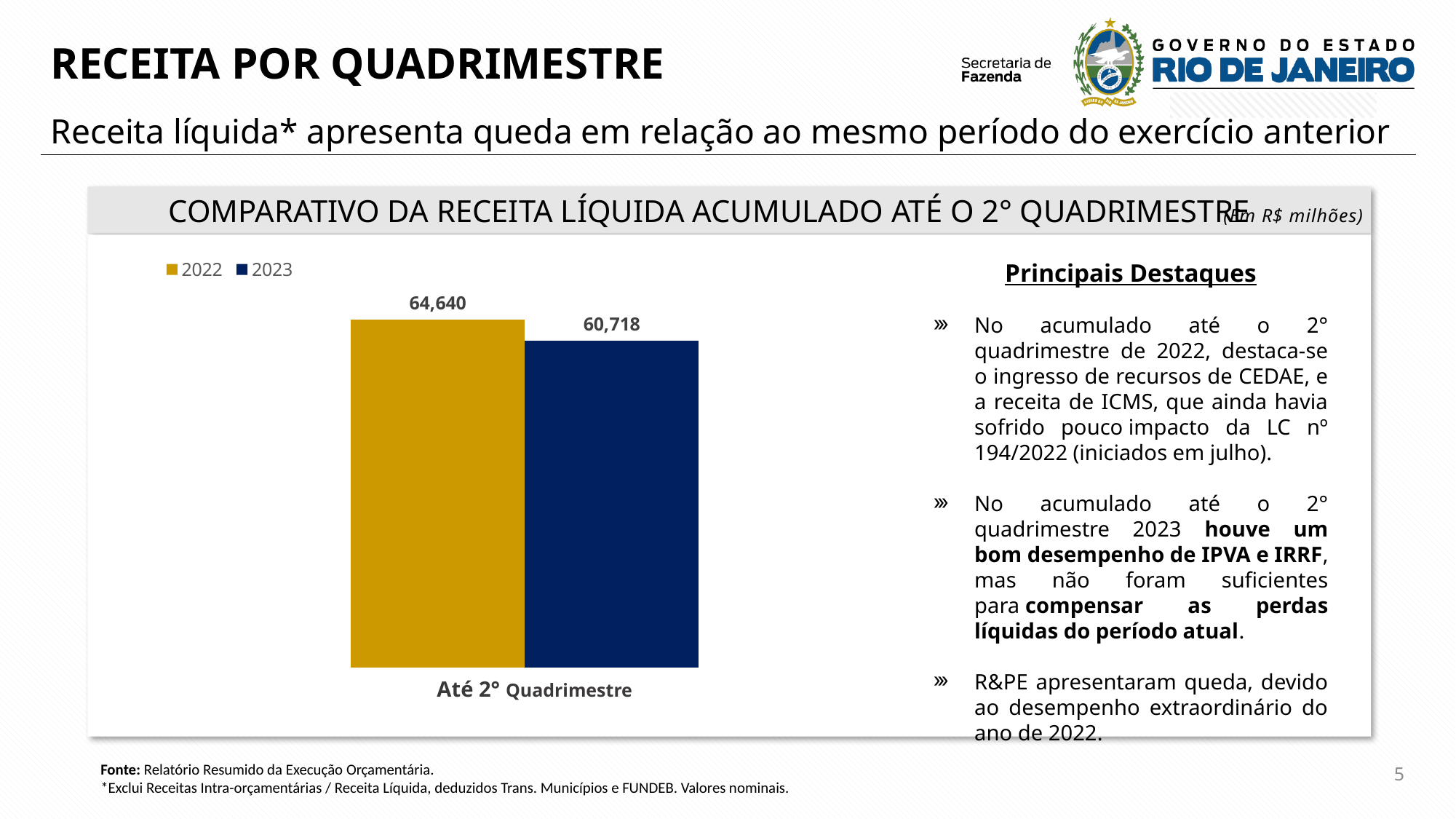
What is the difference between the 2022 and 2023 values? 3,922 Which series has the lowest value in the chart? 2023 Which series has the higher value, 2022 or 2023? 2022 What is the value for 2023 in the chart? 60,718 Does the value fall or rise from 2022 to 2023? Fall What is the category label on the x axis of the chart? Até 2° Quadrimestre How many categories are shown on the x axis of the chart? 1 What is the value for 2022 in the chart? 64,640 How many series does the legend list? 2 What colour is the bar for 2023? Dark blue What kind of chart is shown on the slide? Bar chart